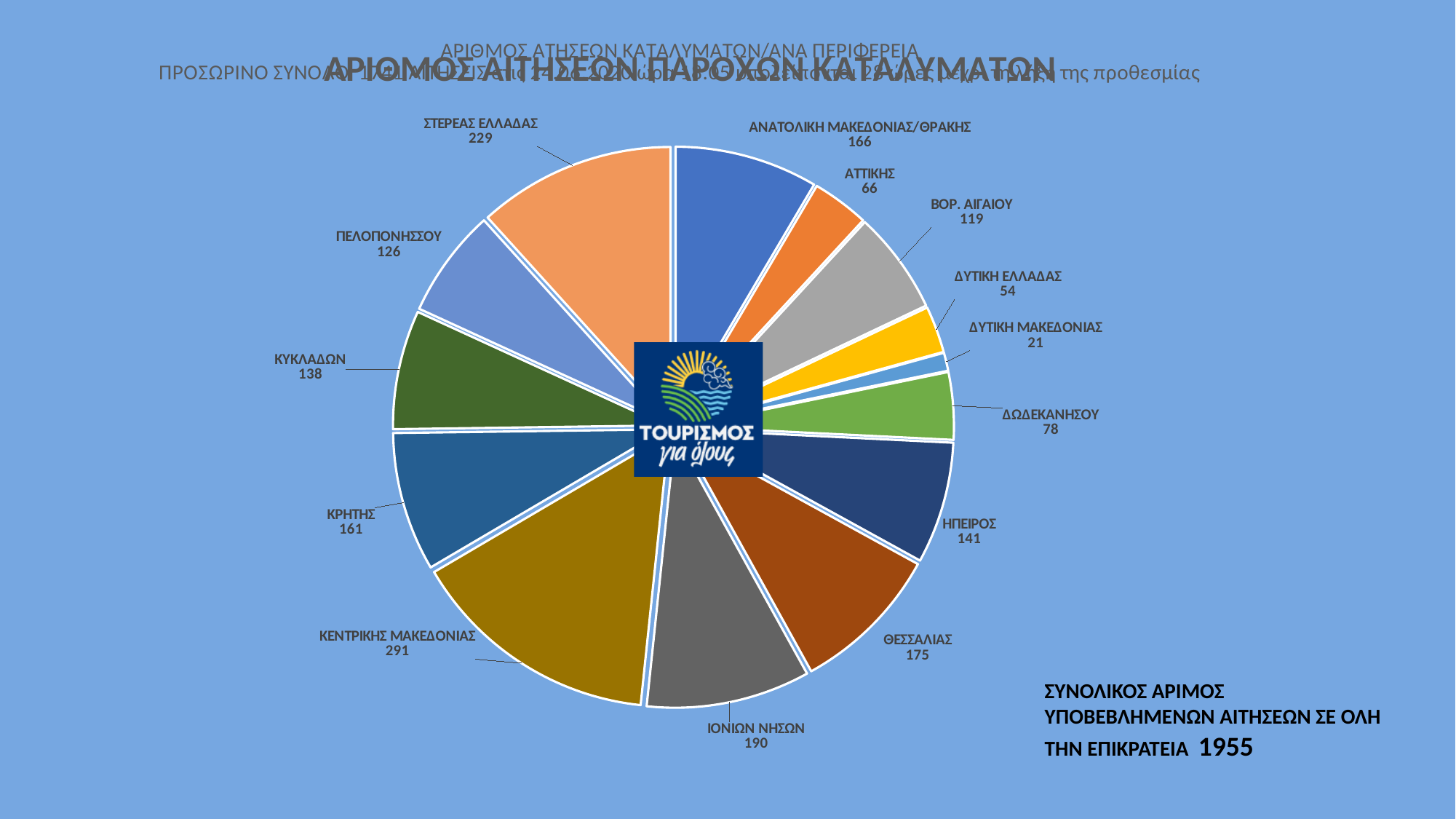
What is the value for ΔΥΤΙΚΗ ΜΑΚΕΔΟΝΙΑΣ? 21 What is the difference between the values for ΣΤΕΡΕΑΣ ΕΛΛΑΔΑΣ and ΚΡΗΤΗΣ? 68 What total number of submitted applications across the whole country is stated on the slide? 1955 What is the value for ΒΟΡ. ΑΙΓΑΙΟΥ? 119 Which region has the lowest value? ΔΥΤΙΚΗ ΜΑΚΕΔΟΝΙΑΣ Which is larger, the value for ΘΕΣΣΑΛΙΑΣ or the value for ΑΝΑΤΟΛΙΚΗ ΜΑΚΕΔΟΝΙΑΣ/ΘΡΑΚΗΣ? ΘΕΣΣΑΛΙΑΣ How many regions (slices) does the pie chart show? 14 What share of the total does ΚΕΝΤΡΙΚΗΣ ΜΑΚΕΔΟΝΙΑΣ represent? 14.9% Which region has the highest value? ΚΕΝΤΡΙΚΗΣ ΜΑΚΕΔΟΝΙΑΣ What type of chart is shown on the slide? pie chart What is the value for ΚΕΝΤΡΙΚΗΣ ΜΑΚΕΔΟΝΙΑΣ? 291 What is the value for ΙΟΝΙΩΝ ΝΗΣΩΝ? 190